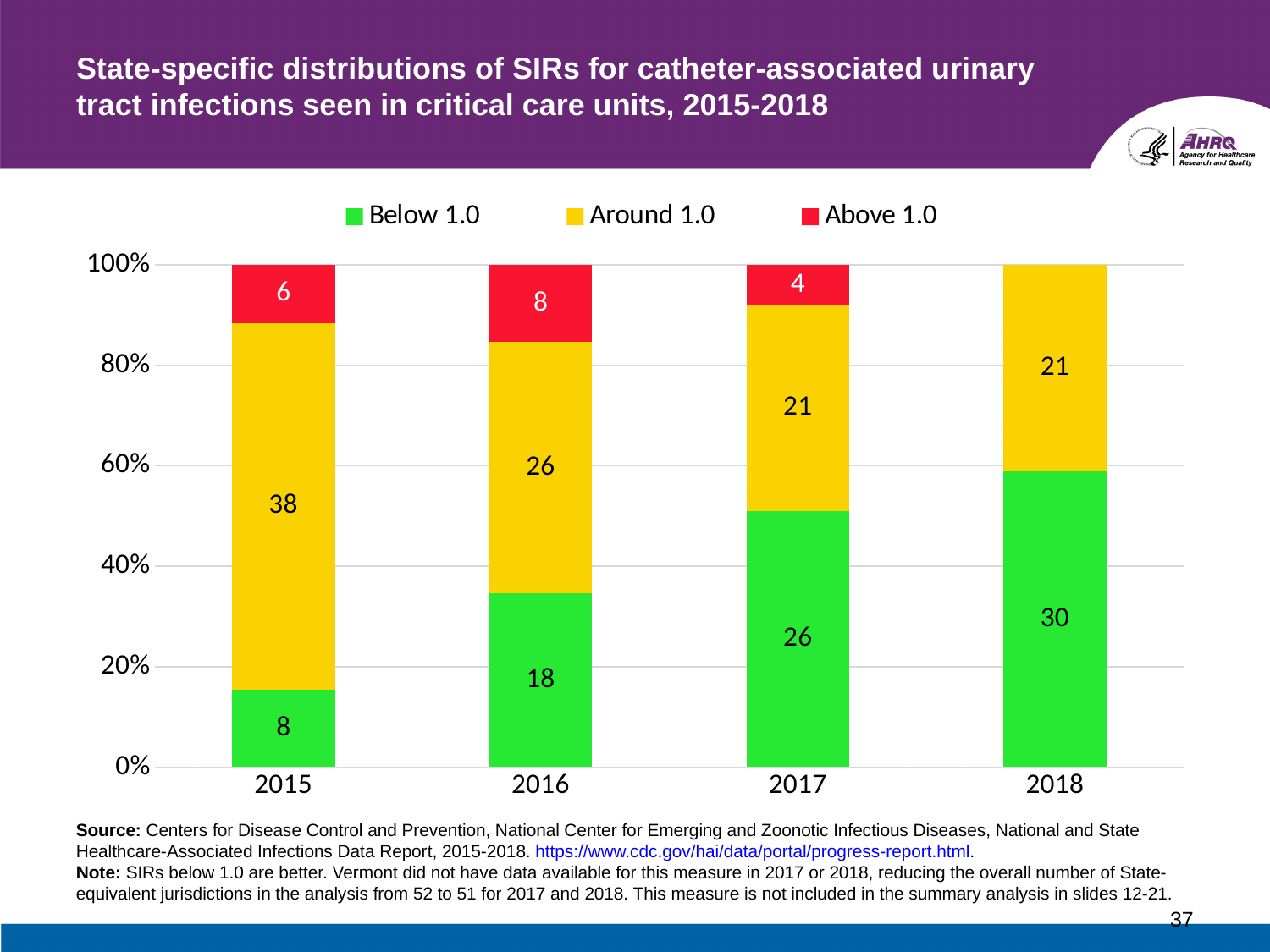
How many years are shown on the x axis? 4 In 2016, which is larger: the Around 1.0 value or the Below 1.0 value? Around 1.0 Does the Below 1.0 value rise or fall from 2015 to 2018? Rise What is the value for Above 1.0 in 2017? 4 What is the difference between the Below 1.0 values for 2018 and 2015? 22 What kind of chart is shown on the slide? Stacked bar chart How many series does the legend list? 3 What is the value for Below 1.0 in 2015? 8 What is the value for Around 1.0 in 2016? 26 What is the total of the stacked bar for 2015? 52 Which year has the highest value for Below 1.0? 2018 Which year has the lowest value for Below 1.0? 2015